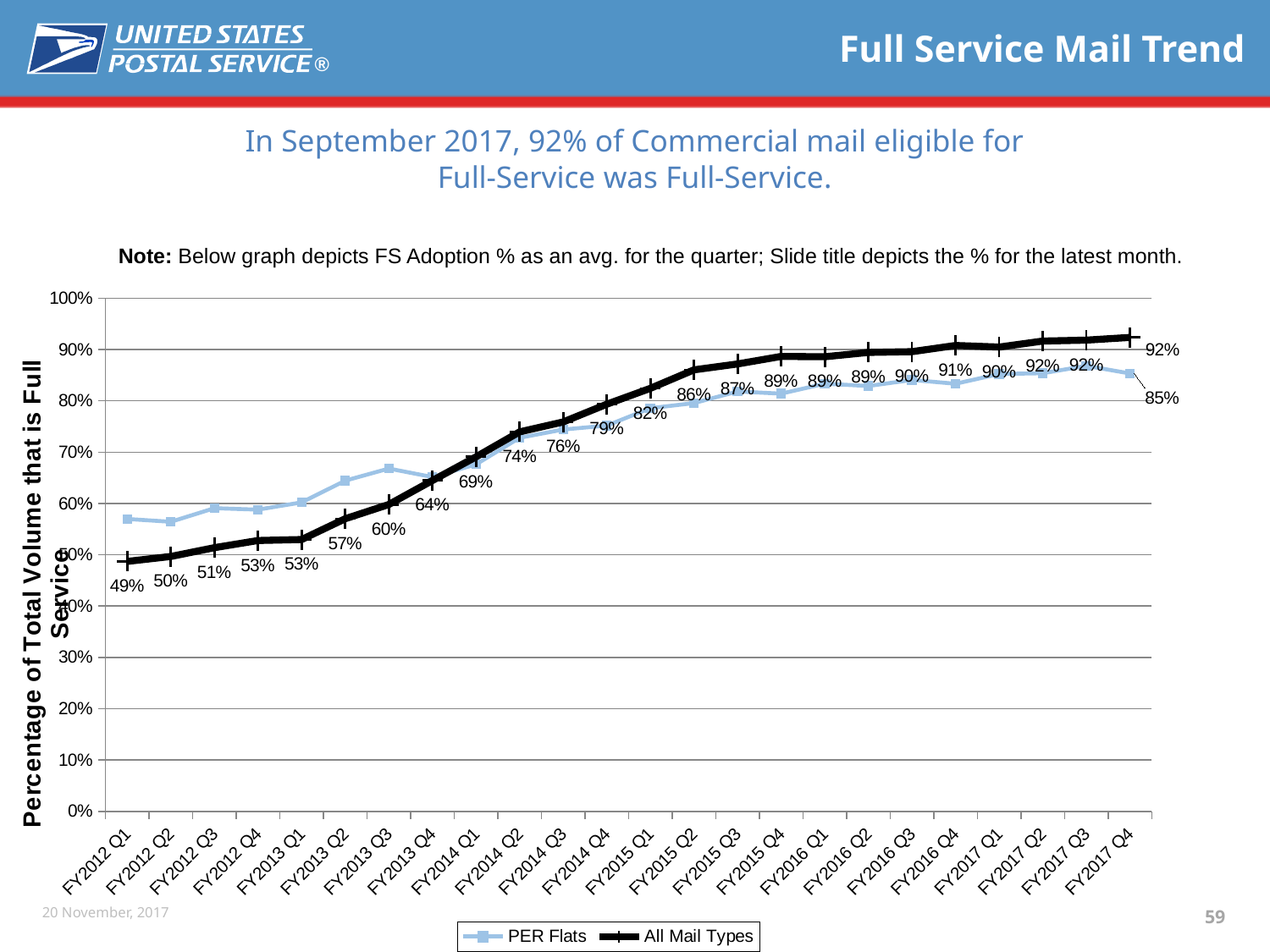
How many quarters are plotted along the x axis? 24 Is the value for PER Flats in FY2012 Q1 greater or less than 50%? greater How many series does the legend list? 2 What are the two series named in the legend? PER Flats and All Mail Types What is the value for All Mail Types in FY2012 Q1? 49% What is the value for PER Flats in FY2017 Q4? 85% What is the value for All Mail Types in FY2017 Q4? 92% What type of chart is shown on the slide? line chart What is the difference between the All Mail Types values in FY2017 Q4 and FY2012 Q1? 43% What is the value for All Mail Types in FY2014 Q1? 69% Does the All Mail Types series generally rise or fall from FY2012 Q1 to FY2017 Q4? rise In which quarter is the All Mail Types value lowest? FY2012 Q1